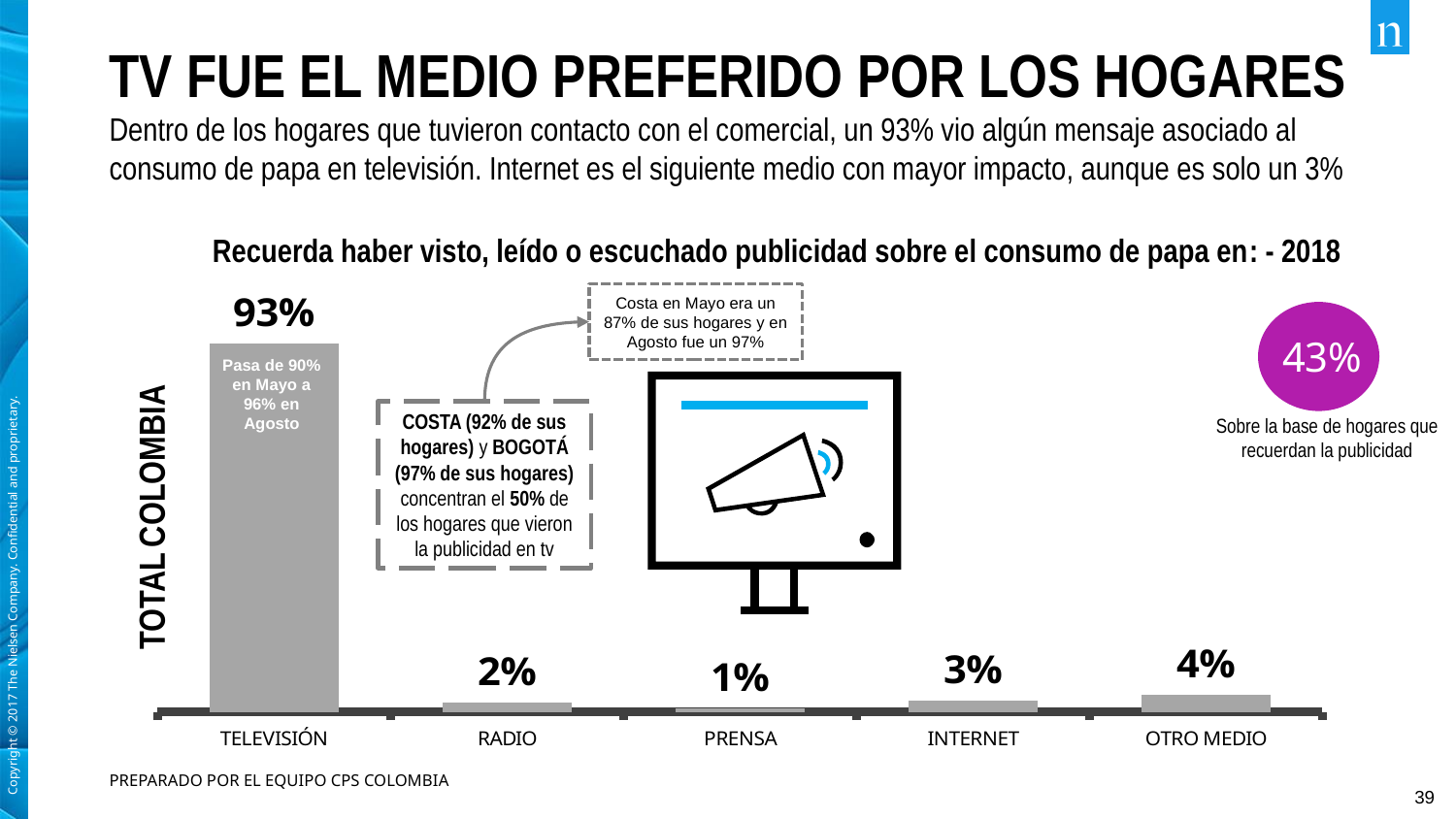
What is the value for RADIO? 2% Which is larger, the value for OTRO MEDIO or the value for RADIO? OTRO MEDIO What is the value for OTRO MEDIO? 4% What is the value for PRENSA? 1% Which category has the lowest value? PRENSA How many categories are shown on the x axis of the chart? 5 What is the difference between the values for TELEVISIÓN and INTERNET? 90% What is the value for TELEVISIÓN? 93% Which category has the highest value? TELEVISIÓN What kind of chart is shown on the slide? Bar chart What is the label on the vertical axis of the chart? TOTAL COLOMBIA What is the value for INTERNET? 3%